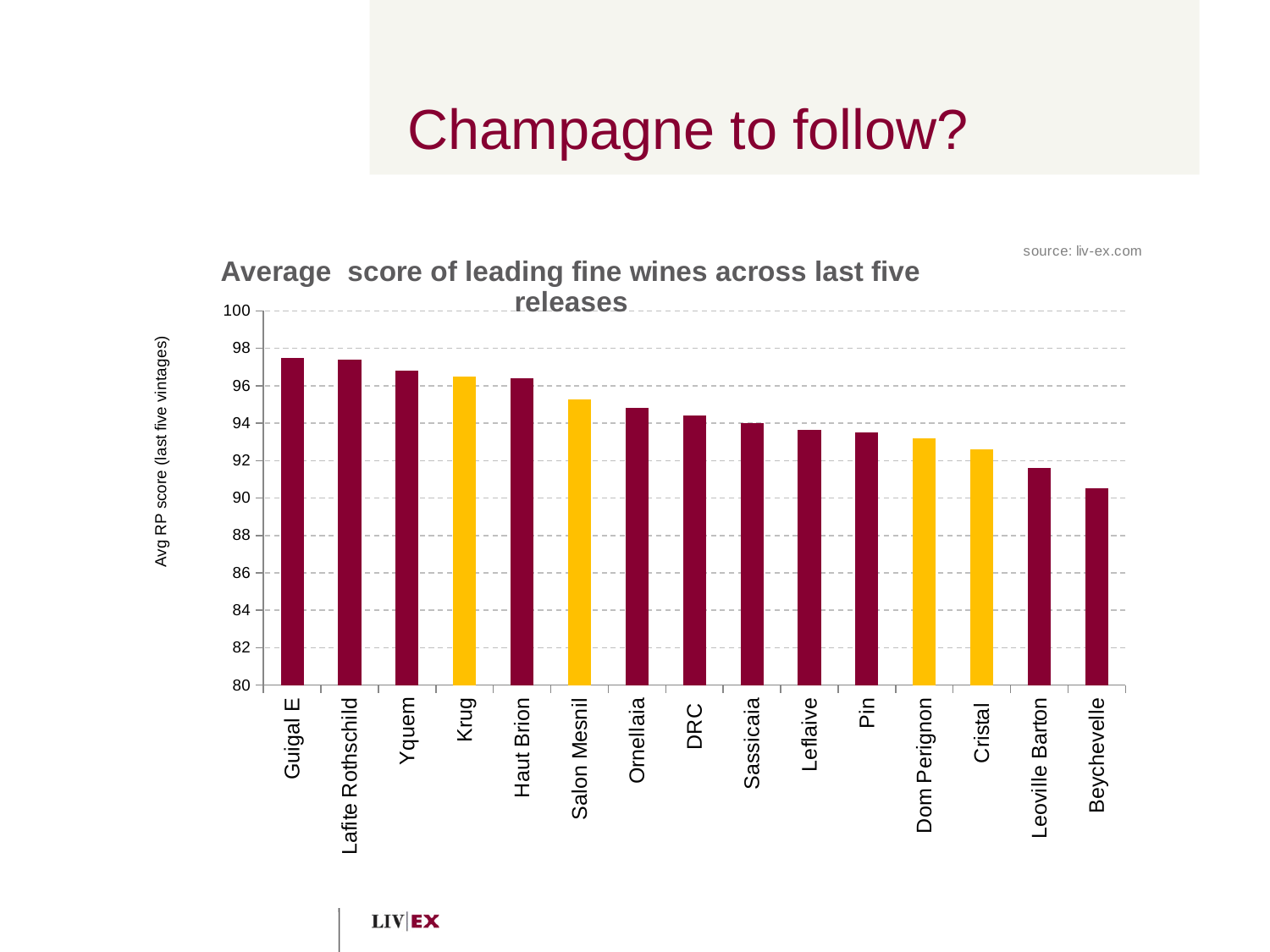
Is the value for Salon Mesnil greater or less than 94? greater What kind of chart is shown on the slide? bar chart Which wine has the lowest average score on the chart? Beychevelle Which has the higher average score, Haut Brion or Pin? Haut Brion Is the value for Beychevelle greater or less than 92? less Is the value for Dom Perignon greater or less than 92? greater Which has the higher average score, Yquem or Cristal? Yquem What is the label on the vertical axis of the chart? Avg RP score (last five vintages) How many wines are plotted on the chart? 15 Do the average scores rise or fall moving from left to right along the x axis? fall